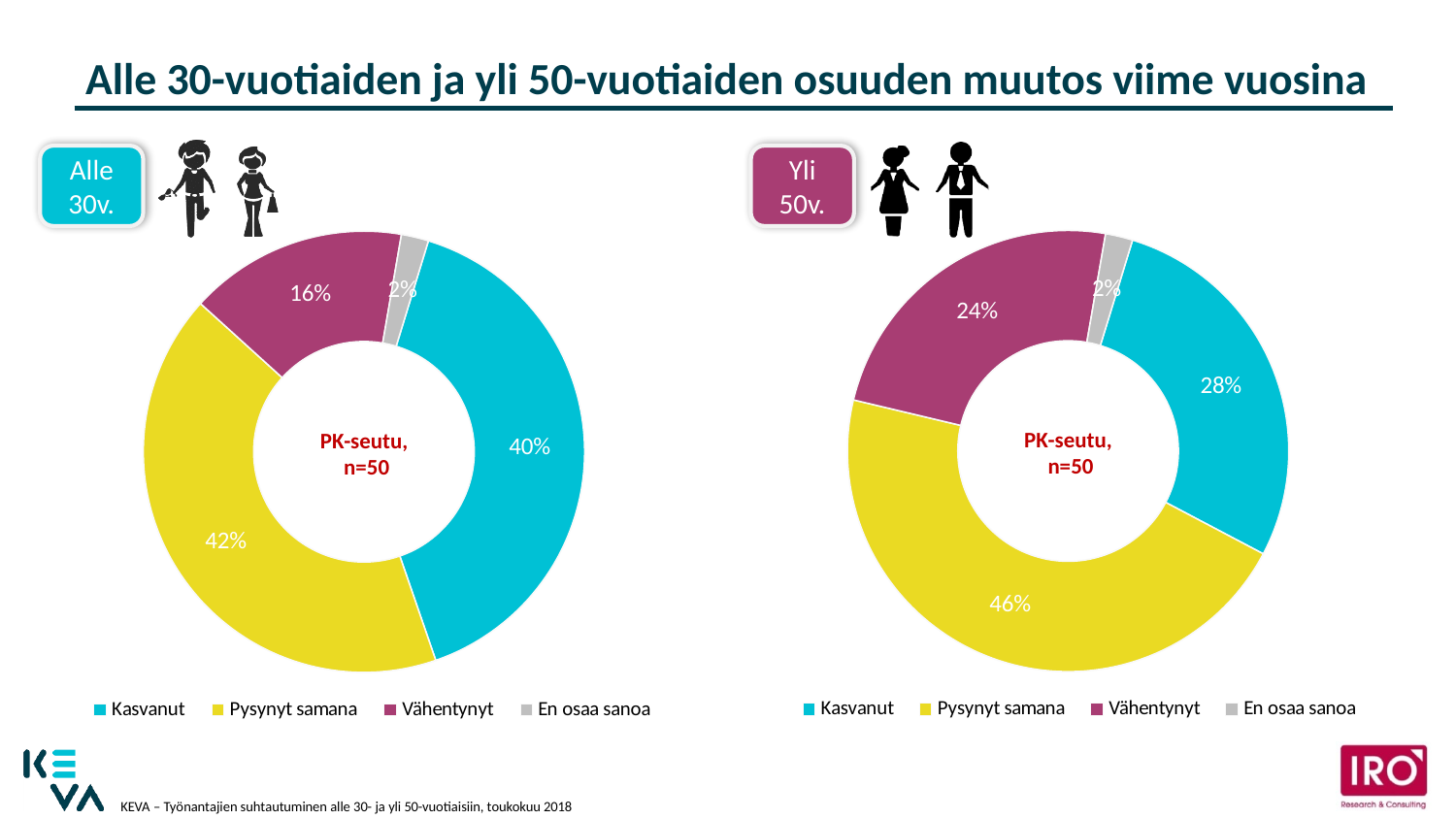
In the 'Yli 50v.' chart on the right, what share is labelled for Vähentynyt? 24% In the 'Alle 30v.' chart on the left, which category has the smallest share? En osaa sanoa In the 'Yli 50v.' chart on the right, what share is labelled for Pysynyt samana? 46% What is the difference in percentage points between Vähentynyt in the 'Yli 50v.' chart and Vähentynyt in the 'Alle 30v.' chart? 8 percentage points In the 'Alle 30v.' chart on the left, what share is labelled for Kasvanut? 40% In the 'Yli 50v.' chart on the right, what share is labelled for Kasvanut? 28% In the 'Alle 30v.' chart on the left, what share is labelled for Pysynyt samana? 42% Which is larger: Kasvanut in the 'Alle 30v.' chart or Kasvanut in the 'Yli 50v.' chart? Kasvanut in the 'Alle 30v.' chart What type of chart is used for the 'Yli 50v.' data on the right? Donut (pie) chart In the 'Yli 50v.' chart on the right, which category has the largest share? Pysynyt samana How many categories does the legend of the 'Alle 30v.' chart list? 4 In the 'Alle 30v.' chart on the left, what share is labelled for Vähentynyt? 16%